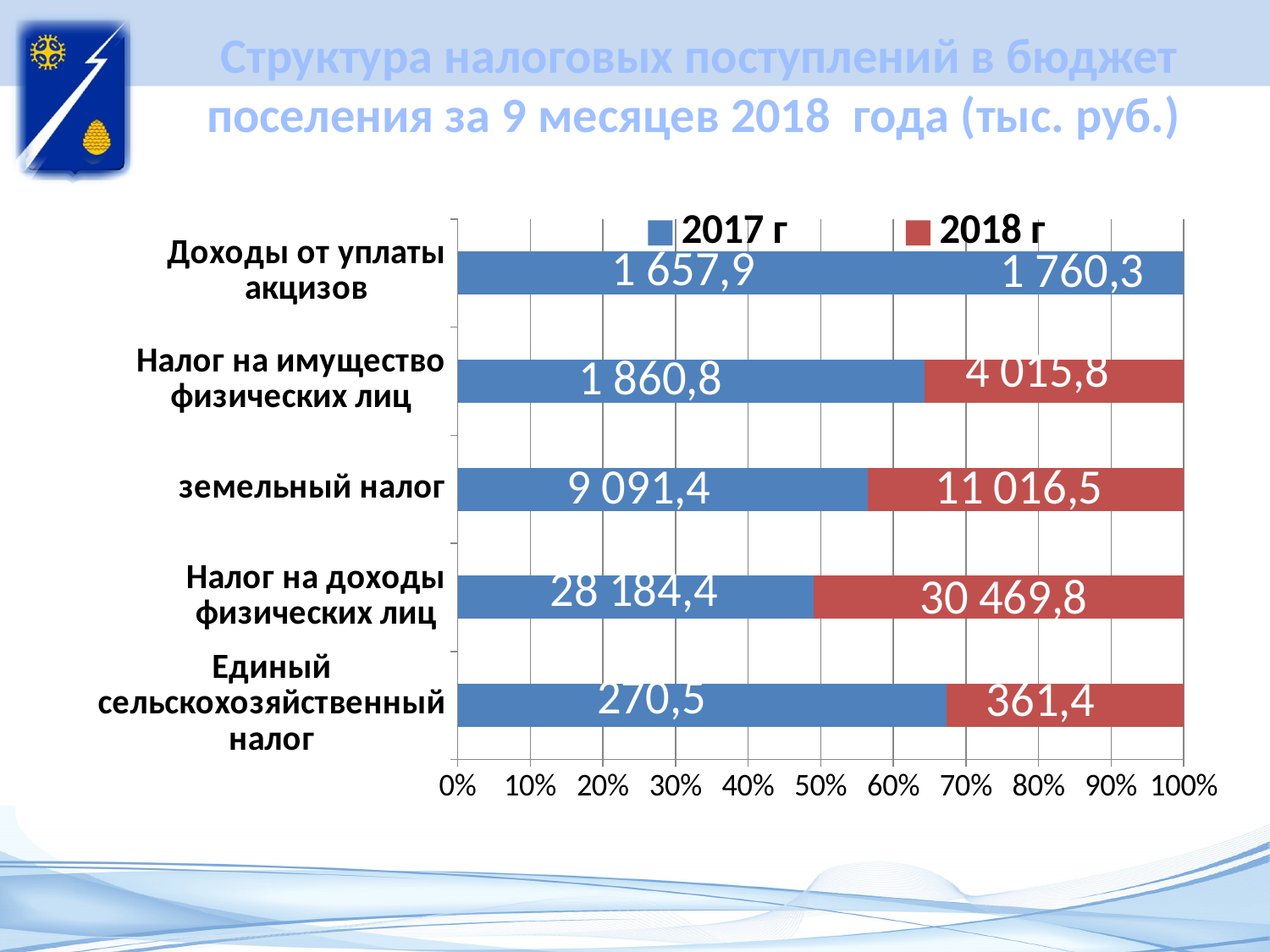
Which category has the highest 2018 г value? Налог на доходы физических лиц How many series does the legend list? 2 What is the 2018 г value for Налог на доходы физических лиц? 30 469,8 What is the 2017 г value for Единый сельскохозяйственный налог? 270,5 For Налог на имущество физических лиц, which is larger: the 2017 г value or the 2018 г value? 2018 г What kind of chart is shown on the slide? Stacked bar chart By how much did земельный налог increase from 2017 г to 2018 г? 1 925,1 What is the 2018 г value for Налог на имущество физических лиц? 4 015,8 What is the difference between the 2018 г and 2017 г values for Доходы от уплаты акцизов? 102,4 Which category has the lowest 2017 г value? Единый сельскохозяйственный налог What is the 2017 г value for земельный налог? 9 091,4 How many tax categories are shown on the chart? 5